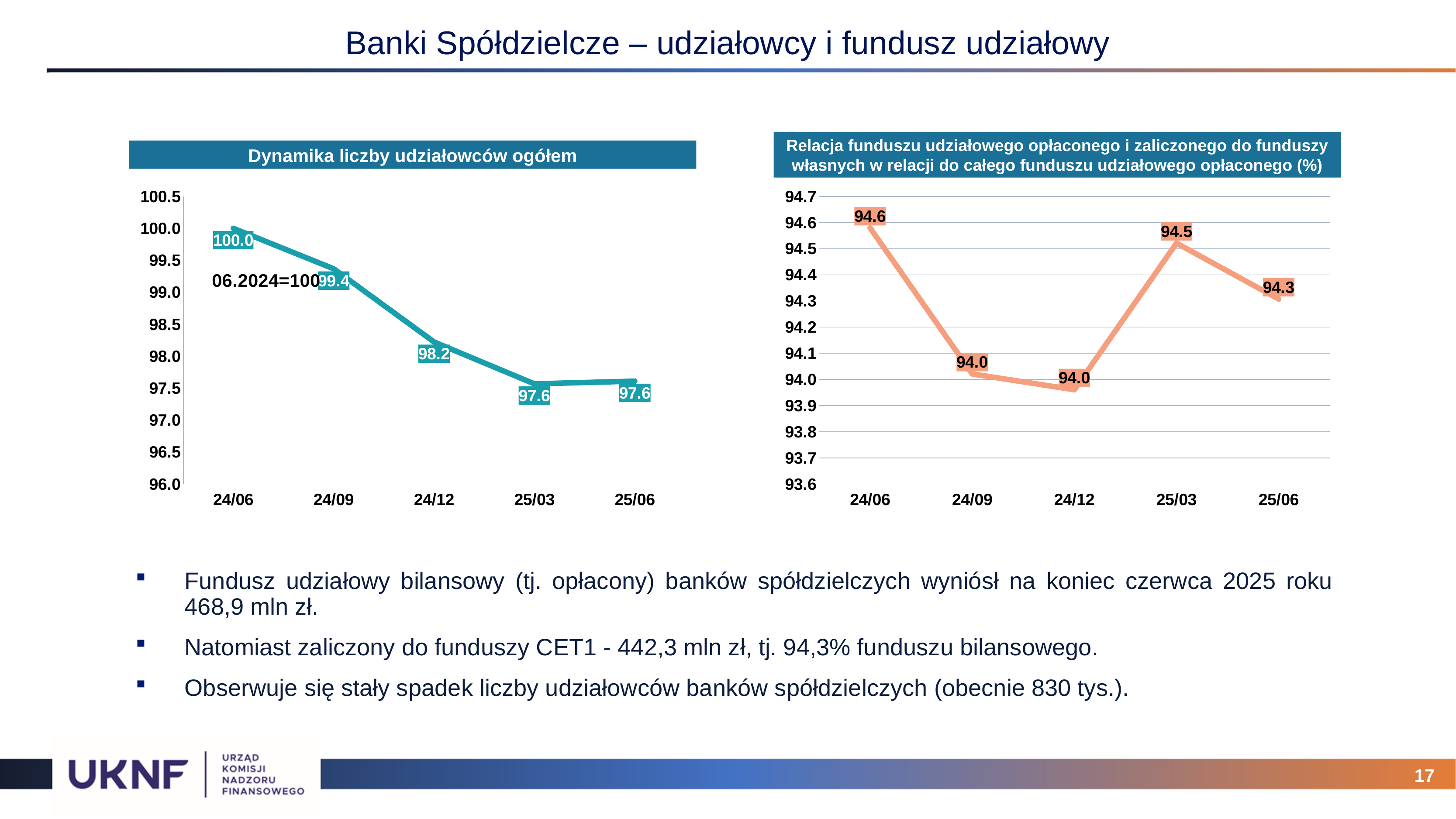
In the right chart 'Relacja funduszu udziałowego opłaconego i zaliczonego do funduszy własnych...', which period has the highest value? 24/06 In the left chart 'Dynamika liczby udziałowców ogółem', what is the value for 24/12? 98.2 In the left chart 'Dynamika liczby udziałowców ogółem', do the values rise or fall from 24/06 to 25/03? fall In the left chart 'Dynamika liczby udziałowców ogółem', what is the value for 24/09? 99.4 In the right chart 'Relacja funduszu udziałowego opłaconego i zaliczonego do funduszy własnych...', what is the value for 25/03? 94.5 In the right chart 'Relacja funduszu udziałowego opłaconego i zaliczonego do funduszy własnych...', what is the value for 25/06? 94.3 What kind of chart is the right chart 'Relacja funduszu udziałowego opłaconego i zaliczonego do funduszy własnych...'? line chart In the right chart 'Relacja funduszu udziałowego opłaconego i zaliczonego do funduszy własnych...', what is the difference between the values for 24/06 and 24/09? 0.6 In the left chart 'Dynamika liczby udziałowców ogółem', what is the difference between the values for 24/06 and 25/06? 2.4 How many data points are plotted in the left chart 'Dynamika liczby udziałowców ogółem'? 5 In the left chart 'Dynamika liczby udziałowców ogółem', which period has the highest value? 24/06 In the right chart 'Relacja funduszu udziałowego opłaconego i zaliczonego do funduszy własnych...', which is larger, the value for 25/03 or the value for 25/06? 25/03